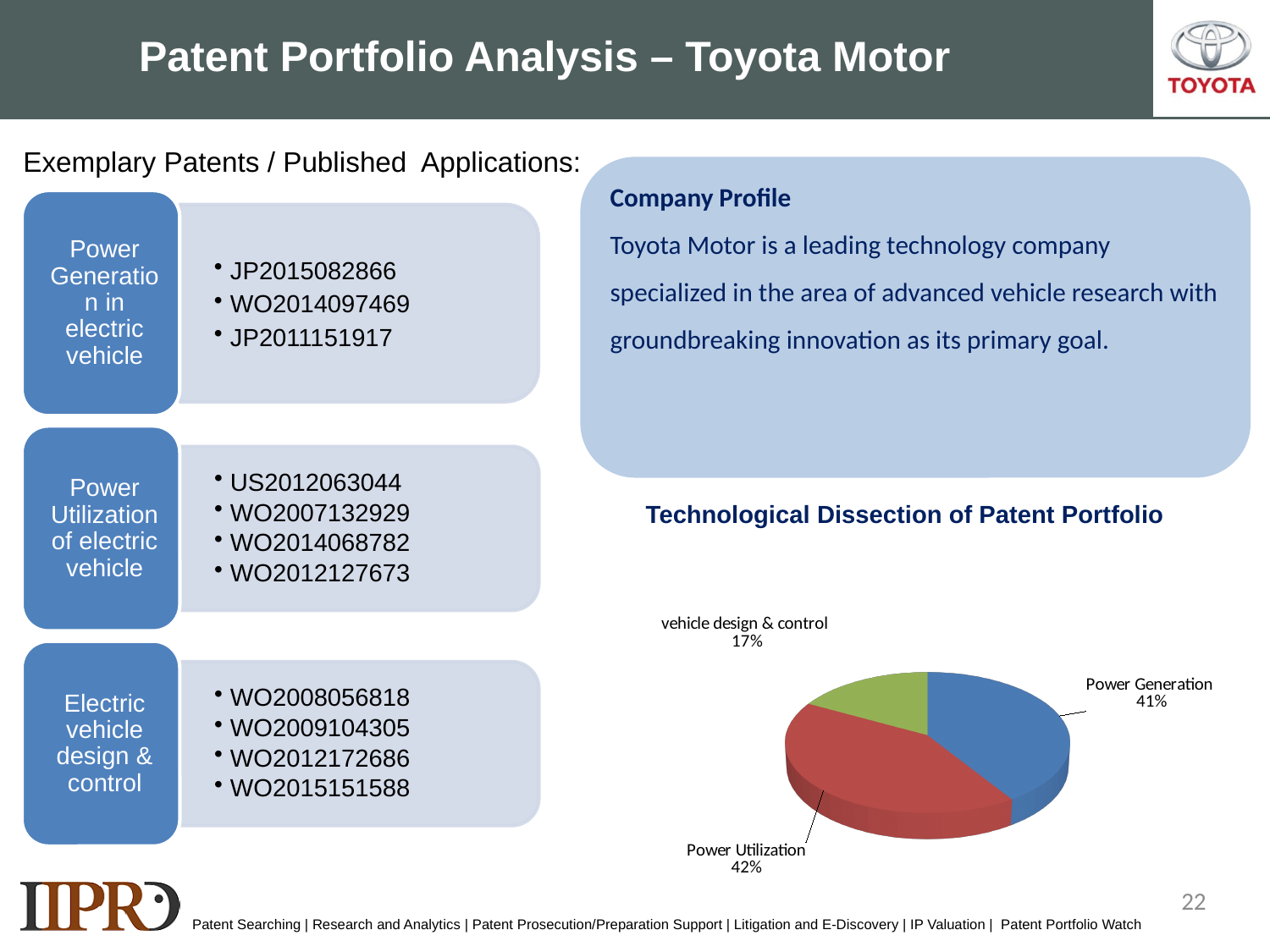
What type of chart is shown under "Technological Dissection of Patent Portfolio"? pie chart Which slice of the pie chart is the smallest? vehicle design & control Which slice of the pie chart is the largest? Power Utilization In the pie chart, what share does vehicle design & control have? 17% In the pie chart, what share does Power Utilization have? 42% In the pie chart, what share does Power Generation have? 41% How many slices does the pie chart have? 3 In the pie chart, what colour is the Power Utilization slice? red What is the title of the pie chart on the slide? Technological Dissection of Patent Portfolio In the pie chart, which is larger: Power Generation or vehicle design & control? Power Generation In the pie chart, what is the difference in percentage points between Power Utilization and Power Generation? 1 In the pie chart, what is the difference in percentage points between Power Generation and vehicle design & control? 24